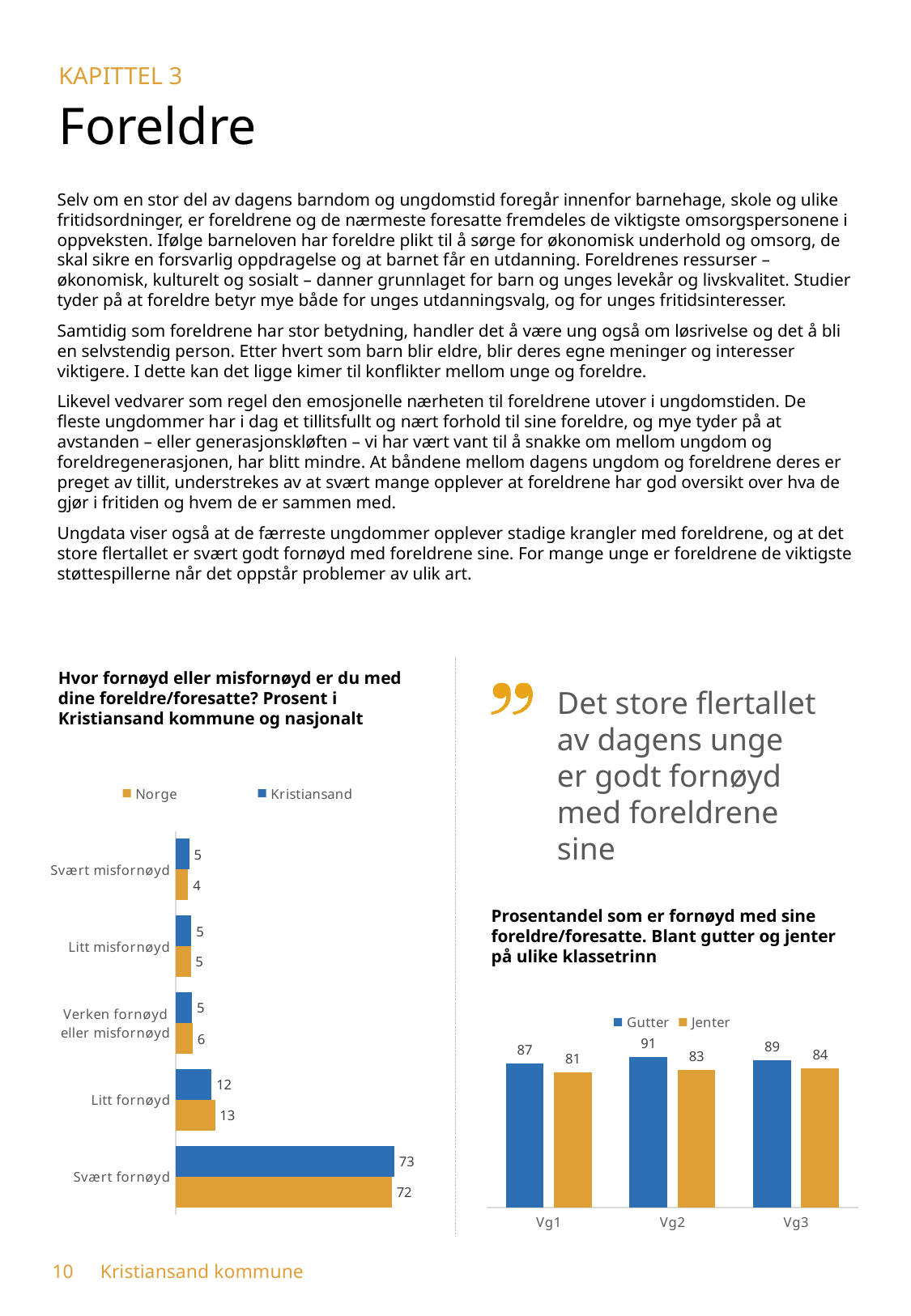
In the left chart on satisfaction with parents, which category has the highest Kristiansand value? Svært fornøyd In the right chart on share satisfied with parents by grade, what is the Gutter value for Vg2? 91 In the right chart on share satisfied with parents by grade, which is larger at Vg2: Gutter or Jenter? Gutter In the left chart on satisfaction with parents, how many categories are shown? 5 In the right chart on share satisfied with parents by grade, what is the difference between Gutter and Jenter at Vg3? 5 In the left chart on satisfaction with parents, what is the difference between the Kristiansand and Norge values for 'Svært misfornøyd'? 1 In the left chart on satisfaction with parents, how many series does the legend list? 2 In the left chart on satisfaction with parents, what is the Kristiansand value for 'Svært fornøyd'? 73 What type of chart is the left chart on satisfaction with parents? Bar chart In the right chart on share satisfied with parents by grade, which grade has the lowest Jenter value? Vg1 In the left chart on satisfaction with parents, what is the Norge value for 'Litt fornøyd'? 13 In the right chart on share satisfied with parents by grade, what is the Jenter value for Vg1? 81